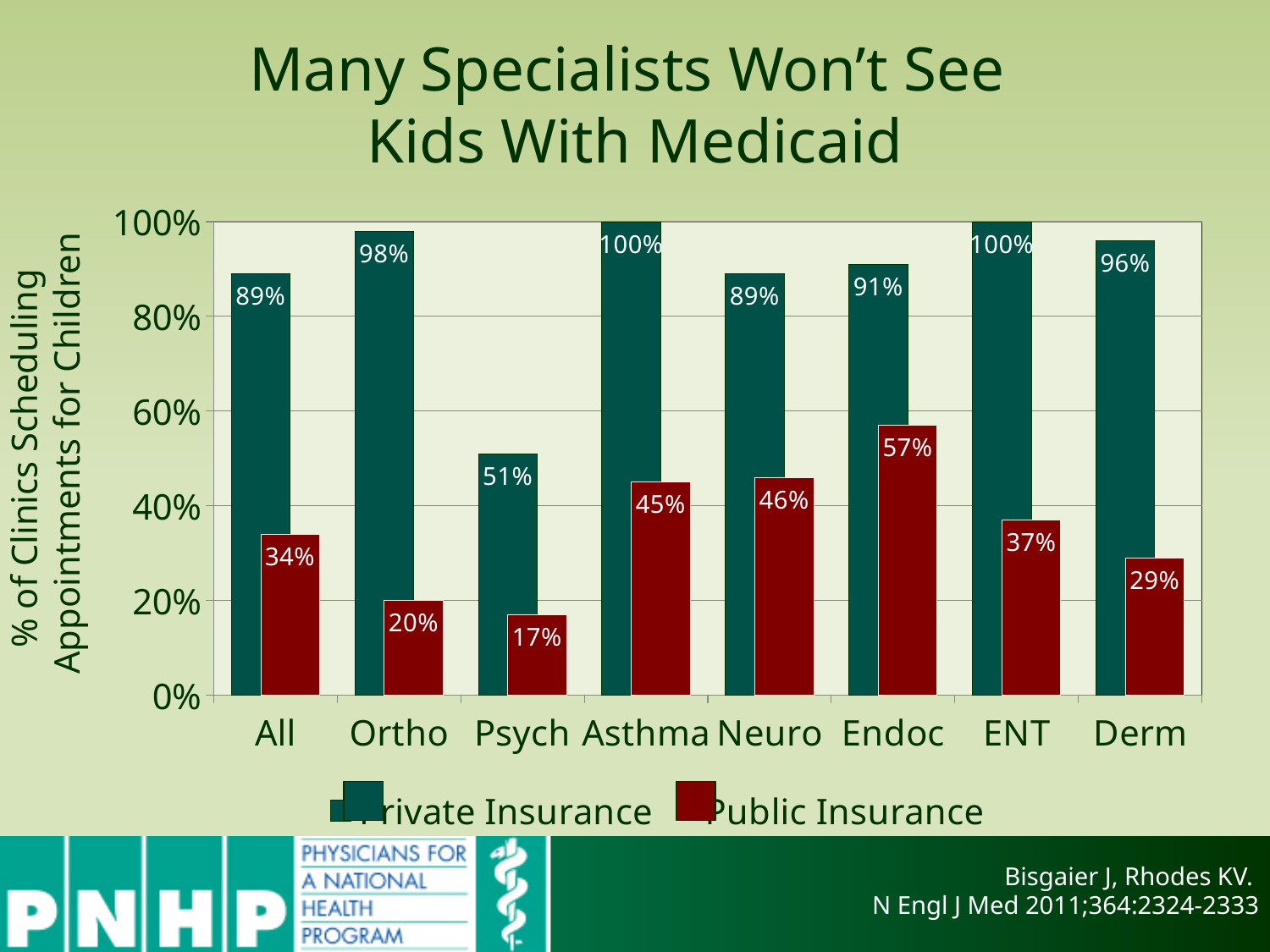
How many categories are shown on the x axis? 8 What is the Public Insurance value for Endoc? 57% What is the Private Insurance value for Ortho? 98% What is the Public Insurance value for Psych? 17% Which category has the lowest Public Insurance value? Psych What is the difference between the Private Insurance and Public Insurance values for Ortho? 78% What is the title of the chart on the slide? Many Specialists Won't See Kids With Medicaid How many series does the legend list? 2 Which category has the highest Public Insurance value? Endoc What kind of chart is shown on the slide? Bar chart Which category has the lowest Private Insurance value? Psych Which is larger: the Public Insurance value for Neuro or for ENT? Neuro